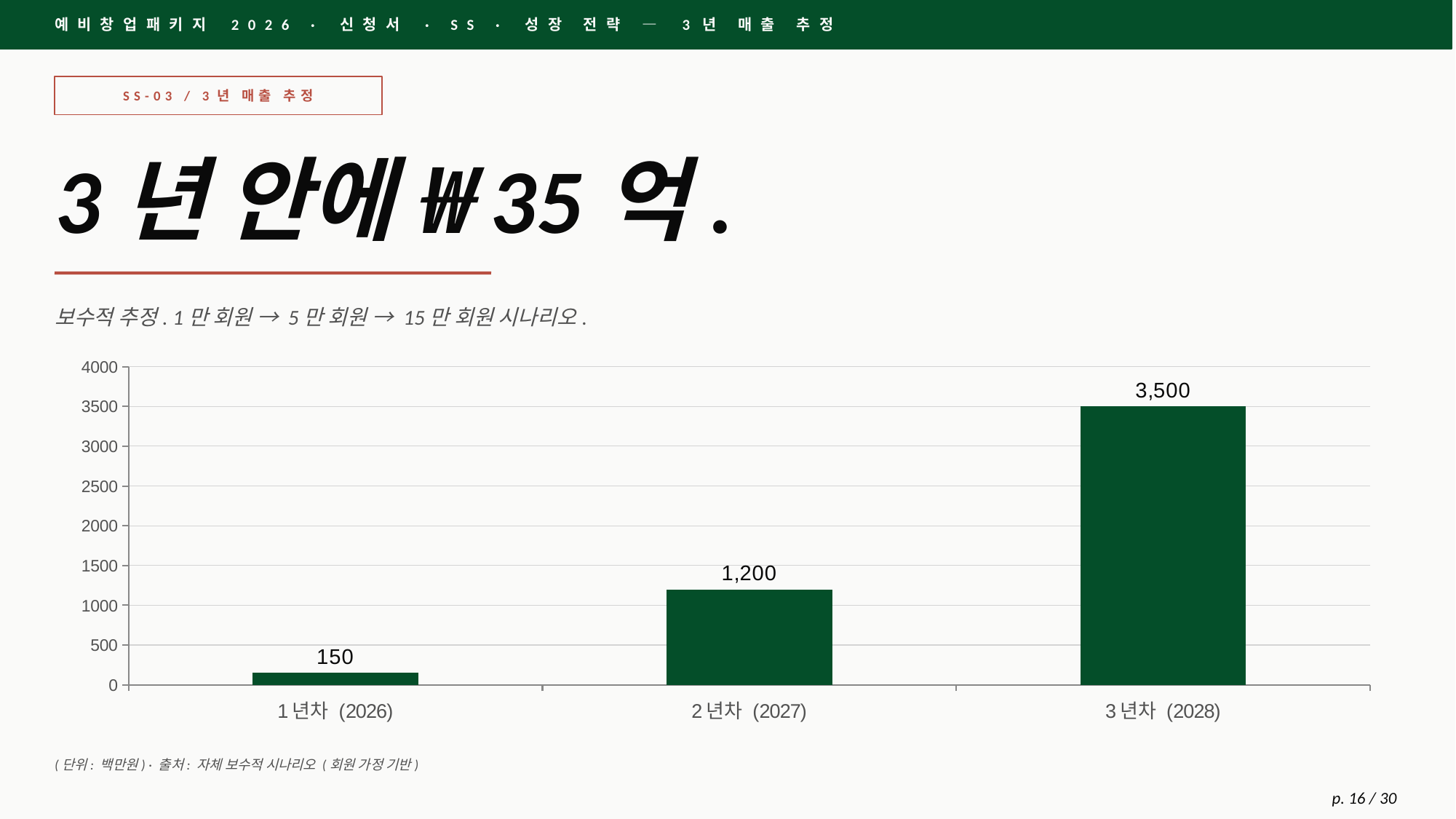
Is the value for 2년차 (2027) greater or less than 1000? greater Do the values rise or fall from 1년차 (2026) to 3년차 (2028)? rise What is the difference between the values for 3년차 (2028) and 2년차 (2027)? 2,300 What kind of chart is shown on the slide? bar chart What is the value for 3년차 (2028)? 3,500 What is the value for 2년차 (2027)? 1,200 Which category has the highest value? 3년차 (2028) Which category has the lowest value? 1년차 (2026) What is the difference between the values for 2년차 (2027) and 1년차 (2026)? 1,050 What is the value for 1년차 (2026)? 150 How many categories are shown on the x axis? 3 Which is larger, the value for 2년차 (2027) or 1년차 (2026)? 2년차 (2027)